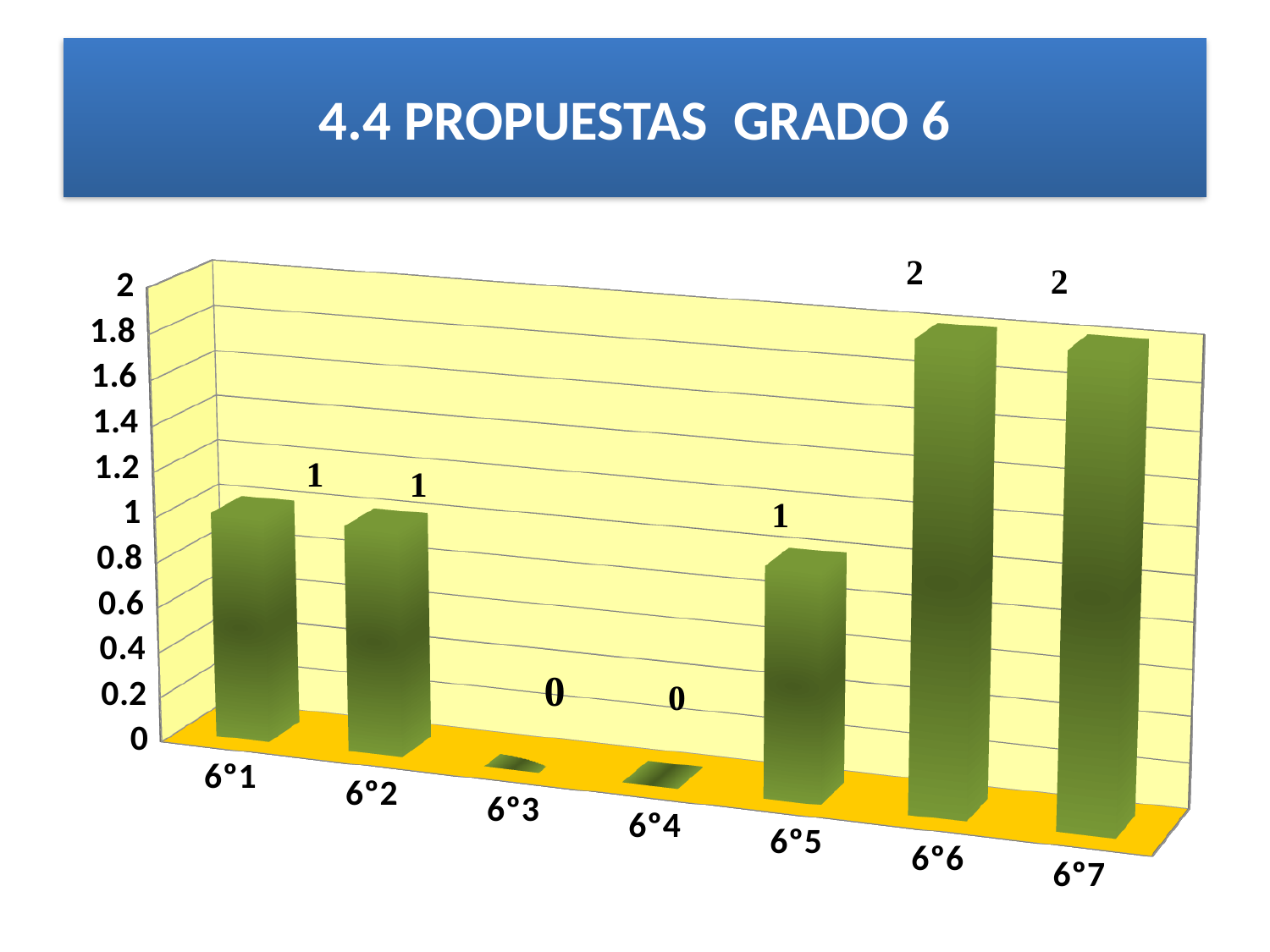
What is the title of the slide? 4.4 PROPUESTAS GRADO 6 Which is larger, the value for 6°7 or the value for 6°5? 6°7 What is the value for 6°6? 2 What is the value for 6°1? 1 What is the maximum value shown on the vertical axis? 2 What is the difference between the values for 6°6 and 6°2? 1 What is the value for 6°5? 1 How many categories are shown on the x axis? 7 Which categories have the highest value? 6°6 and 6°7 Which categories have the lowest value? 6°3 and 6°4 What is the value for 6°3? 0 What kind of chart is shown on the slide? bar chart